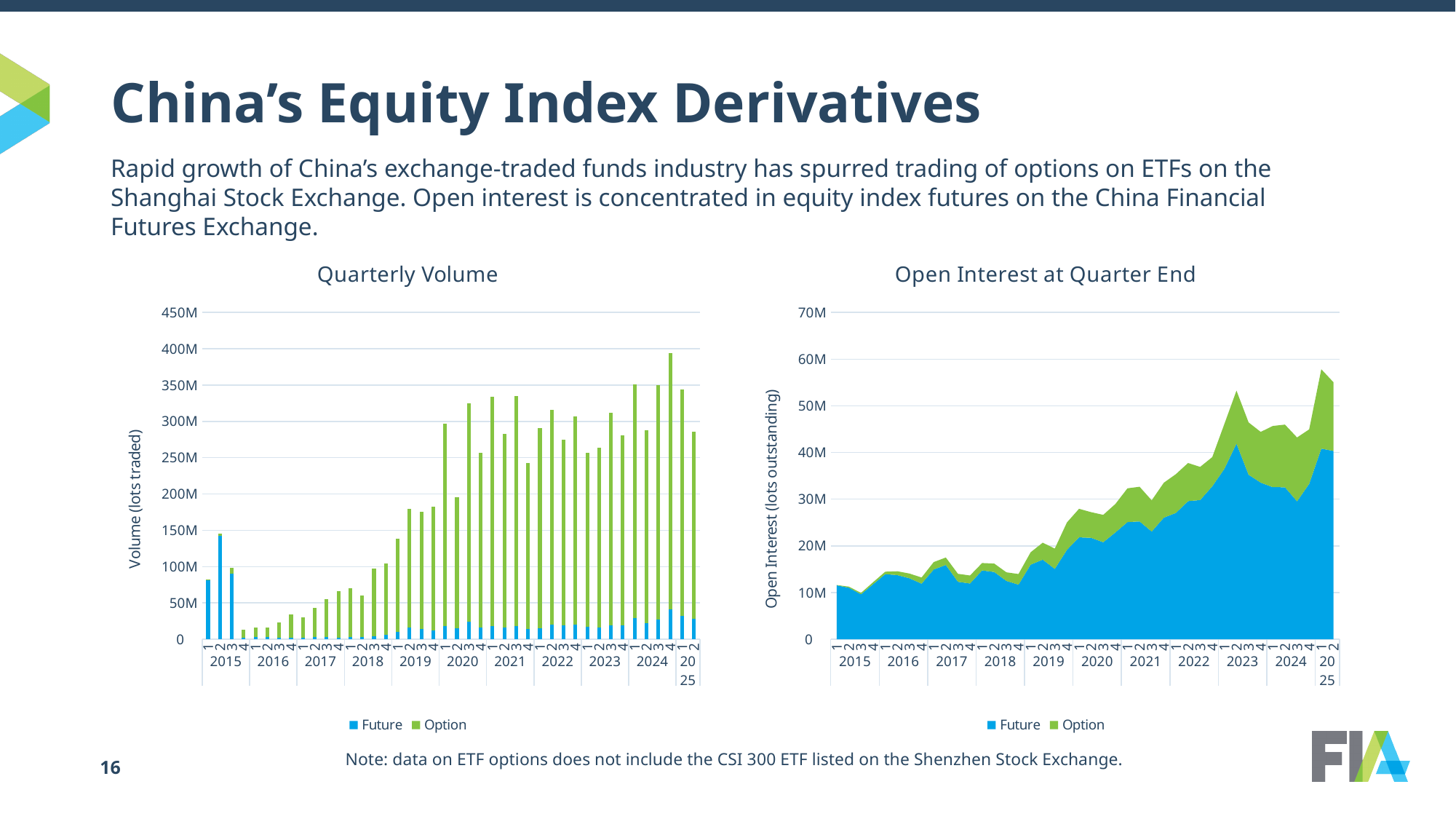
How many series does the legend of the Quarterly Volume chart list? 2 In the Quarterly Volume chart, is the total volume for Q4 2024 greater or less than 350M? greater In the Quarterly Volume chart, is the total volume for Q1 2015 greater or less than 100M? less In the Open Interest at Quarter End chart, does total open interest generally rise or fall from 2015 to 2025? Rise In the Quarterly Volume chart, is the total volume for Q3 2020 greater or less than 300M? greater In the Open Interest at Quarter End chart, which series is shown in green? Option In the Quarterly Volume chart, which quarter has the highest total volume? Q4 2024 What is the y-axis label of the Quarterly Volume chart? Volume (lots traded) In the Quarterly Volume chart, which is larger, the total volume for Q4 2024 or for Q1 2025? Q4 2024 What kind of chart is the Open Interest at Quarter End chart? Area chart What kind of chart is the Quarterly Volume chart? Bar chart